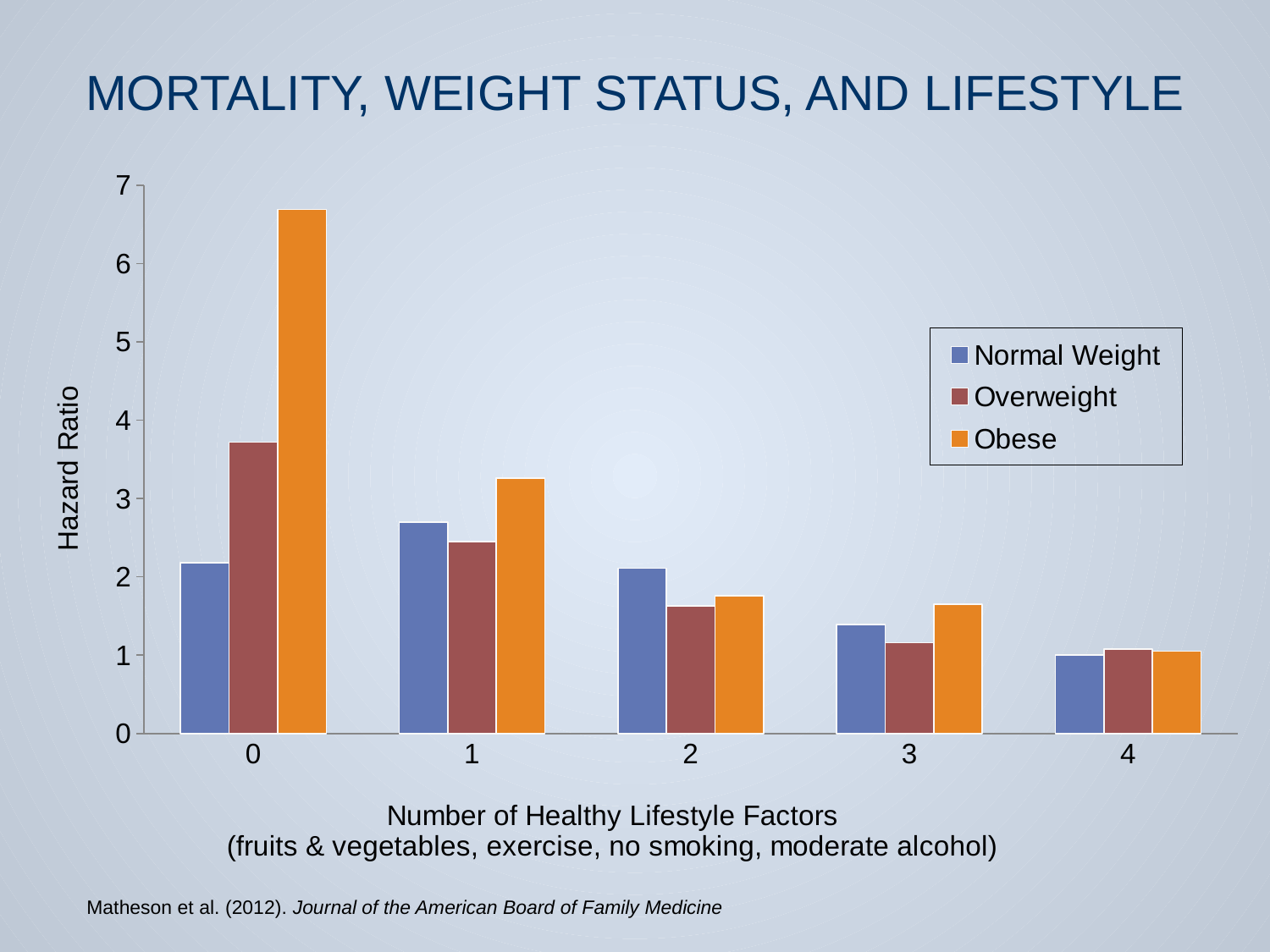
What is the title of the y axis? Hazard Ratio Does the Obese hazard ratio rise or fall as the number of healthy lifestyle factors increases from 0 to 4? Fall What kind of chart is shown on the slide? Bar chart At 2 healthy lifestyle factors, which is larger: the Normal Weight or the Overweight hazard ratio? Normal Weight Is the Obese hazard ratio at 0 healthy lifestyle factors greater or less than 6? greater Is the Obese hazard ratio at 1 healthy lifestyle factor greater or less than 3? greater Is the Overweight hazard ratio at 3 healthy lifestyle factors greater or less than 2? less For which number of healthy lifestyle factors is the Obese hazard ratio highest? 0 How many series does the legend list? 3 For which number of healthy lifestyle factors is the Normal Weight hazard ratio lowest? 4 At 0 healthy lifestyle factors, which is larger: the Obese or the Overweight hazard ratio? Obese How many categories are shown on the x axis? 5